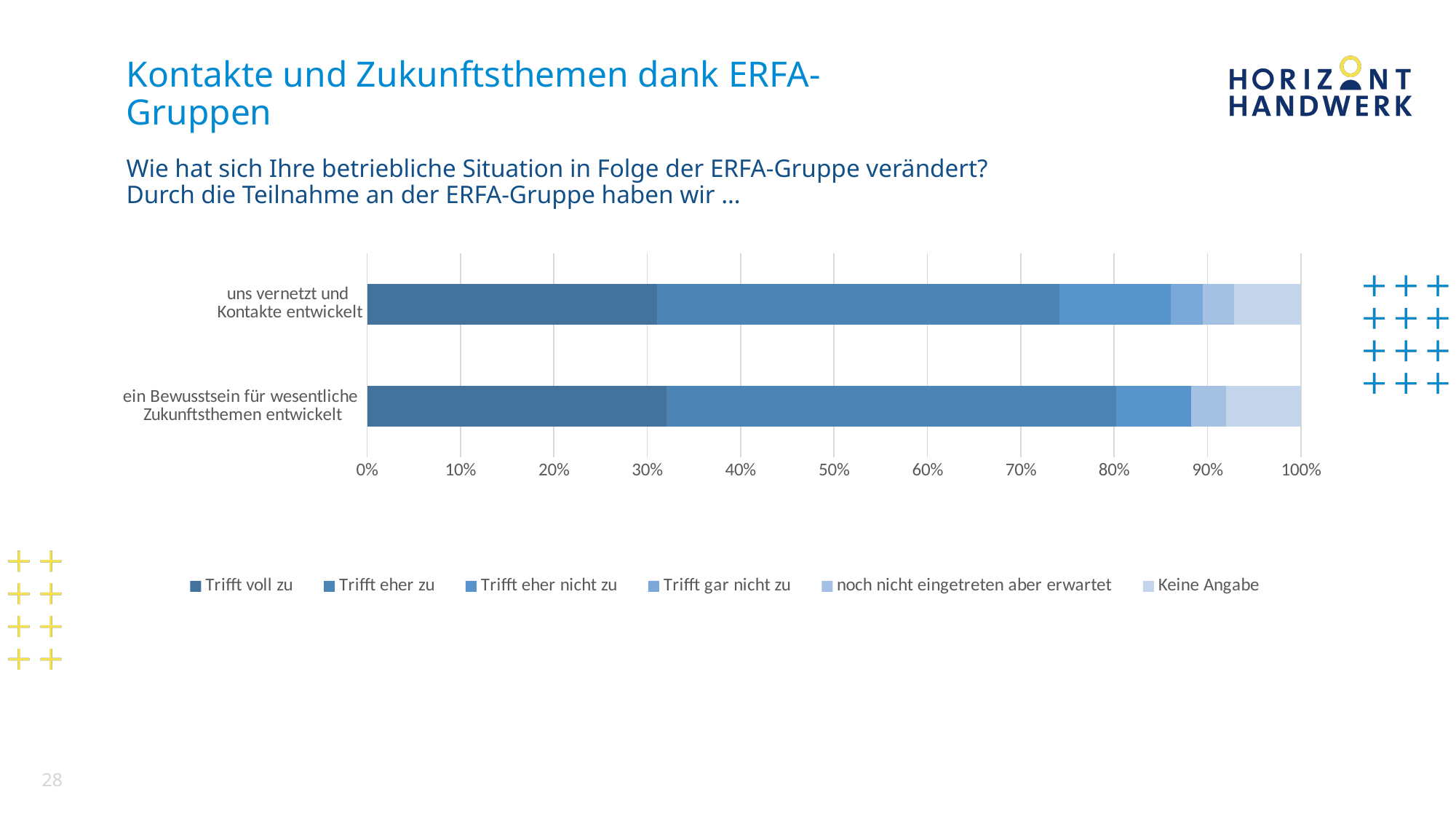
What is the maximum value shown on the x axis? 100% What is the first series listed in the legend? Trifft voll zu Is the 'Trifft eher zu' value for 'ein Bewusstsein für wesentliche Zukunftsthemen entwickelt' greater or less than 40%? greater Is the 'Trifft eher zu' value for 'uns vernetzt und Kontakte entwickelt' greater or less than 50%? less Is the 'Trifft voll zu' value for 'ein Bewusstsein für wesentliche Zukunftsthemen entwickelt' greater or less than 20%? greater Which category has the larger 'Trifft eher zu' segment? ein Bewusstsein für wesentliche Zukunftsthemen entwickelt How many series does the legend list? 6 What kind of chart is shown on the slide? stacked bar chart What is the total of the stacked bar for 'uns vernetzt und Kontakte entwickelt'? 100% How many categories (bars) does the chart show? 2